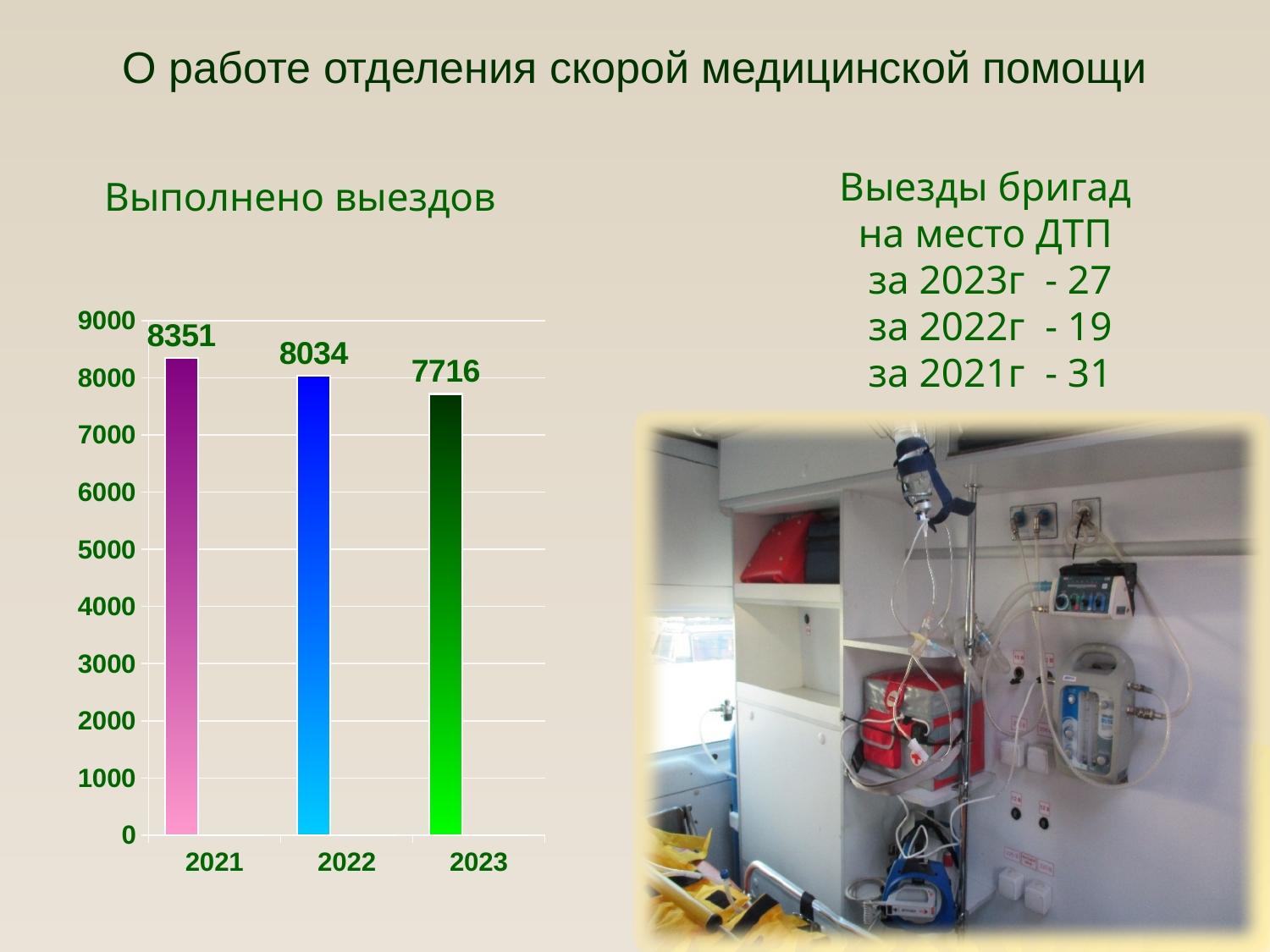
Which is larger in the 'Выполнено выездов' chart, the value for 2022 or the value for 2023? 2022 What is the value for 2023 in the 'Выполнено выездов' chart? 7716 Which year has the lowest value in the 'Выполнено выездов' chart? 2023 What is the value for 2021 in the 'Выполнено выездов' chart? 8351 What is the value for 2022 in the 'Выполнено выездов' chart? 8034 Which year has the highest value in the 'Выполнено выездов' chart? 2021 Do the values in the 'Выполнено выездов' chart rise or fall from 2021 to 2023? fall What kind of chart is 'Выполнено выездов'? bar chart Is the value for 2023 in the 'Выполнено выездов' chart greater or less than 8000? less What is the difference between the 2021 and 2023 values in the 'Выполнено выездов' chart? 635 What is the difference between the 2021 and 2022 values in the 'Выполнено выездов' chart? 317 How many years are shown in the 'Выполнено выездов' chart? 3